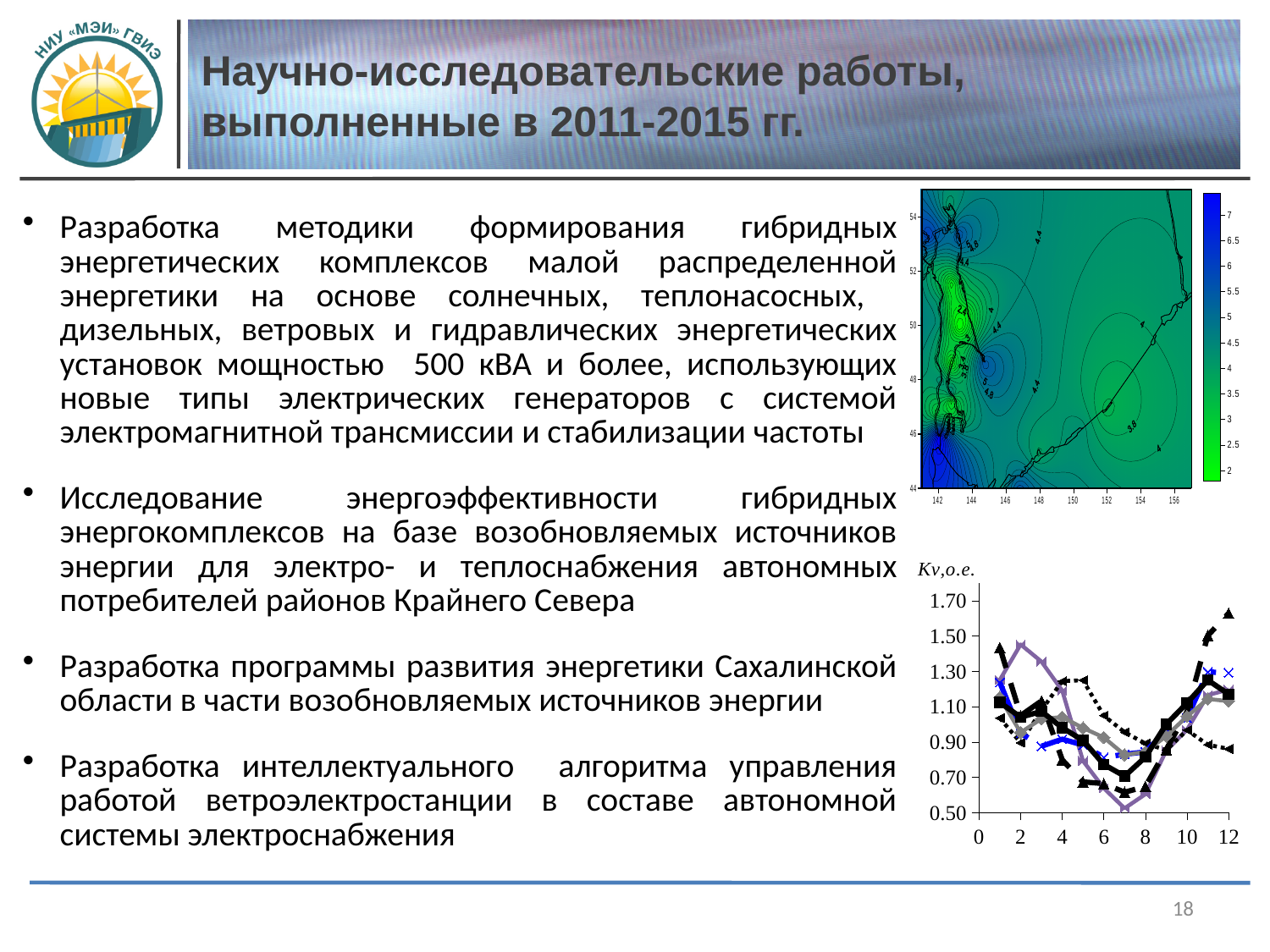
In the bottom-right line chart, how many tick labels are shown on the x axis? 7 In the bottom-right line chart, what is the largest value labelled on the x axis? 12 In the bottom-right line chart, is the value of the purple line at x = 2 greater or less than 1.30? greater In the bottom-right line chart, what is the lowest value shown on the y axis? 0.50 In the bottom-right line chart, what is the label on the y axis? Kv,o.e. In the top-right contour map, what is the highest value on the colour scale bar? 7 In the top-right contour map, what is the lowest value on the colour scale bar? 2 In the bottom-right line chart, is the value of the purple line at x = 7 greater or less than 0.70? less In the bottom-right line chart, does the purple line rise or fall between x = 7 and x = 12? rise In the bottom-right line chart, does the purple line rise or fall between x = 2 and x = 7? fall In the bottom-right line chart, what is the highest value shown on the y axis? 1.70 What kind of chart is the bottom-right chart with the y-axis labelled Kv,o.e.? line chart